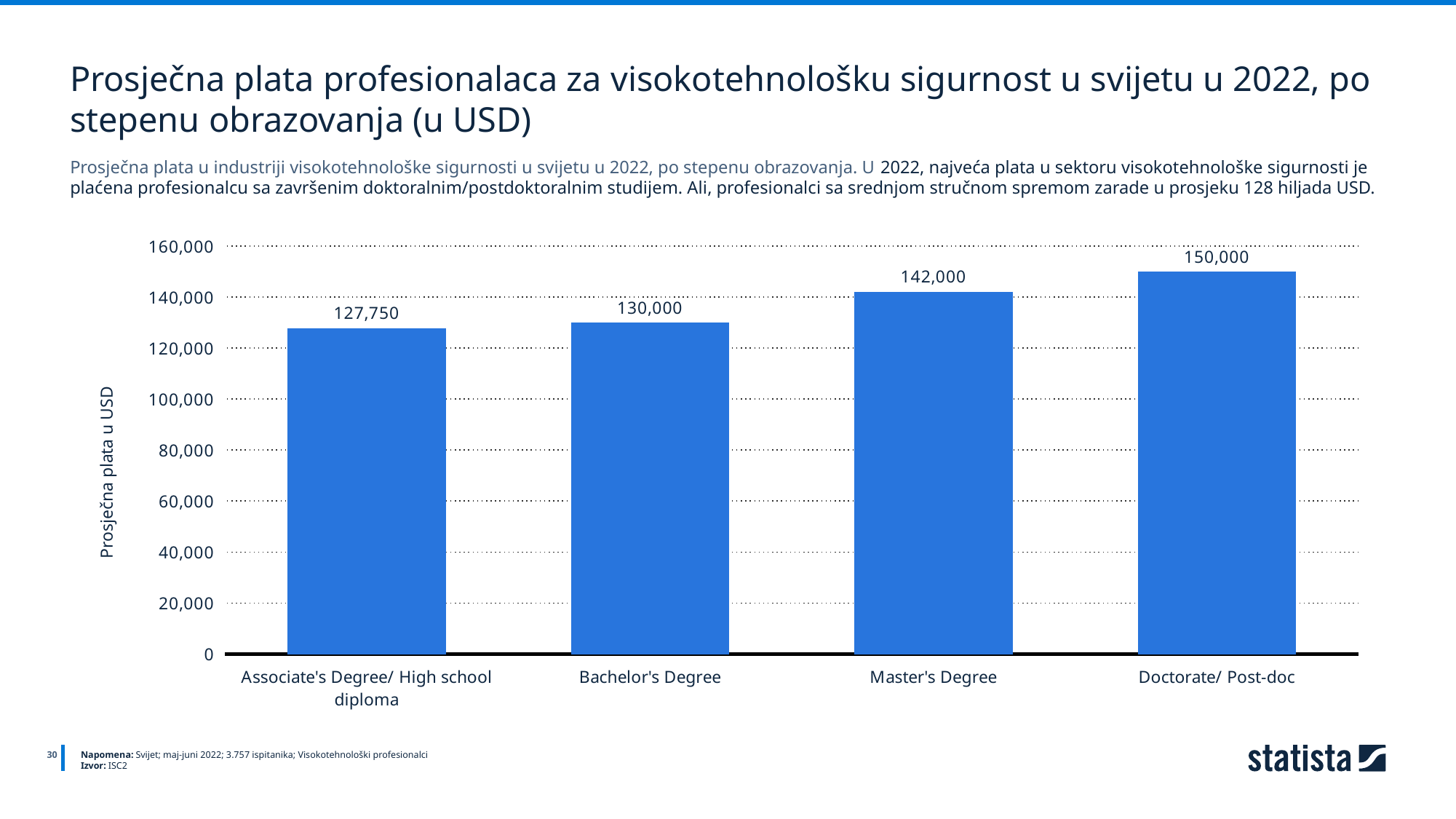
What is the average salary for professionals with a Bachelor's Degree? 130,000 What is the average salary for professionals with an Associate's Degree/ High school diploma? 127,750 What is the difference between the average salary for Doctorate/ Post-doc and Master's Degree? 8,000 What kind of chart is shown on the slide? Bar chart Do the values rise or fall from left to right across the education levels? Rise How many education levels are shown on the chart? 4 Is the value for Doctorate/ Post-doc greater or less than 140,000? greater Which education level has the lowest average salary? Associate's Degree/ High school diploma Which is larger, the average salary for Master's Degree or for Bachelor's Degree? Master's Degree What is the difference between the average salary for Bachelor's Degree and Associate's Degree/ High school diploma? 2,250 Which education level has the highest average salary? Doctorate/ Post-doc What is the average salary for professionals with a Master's Degree? 142,000